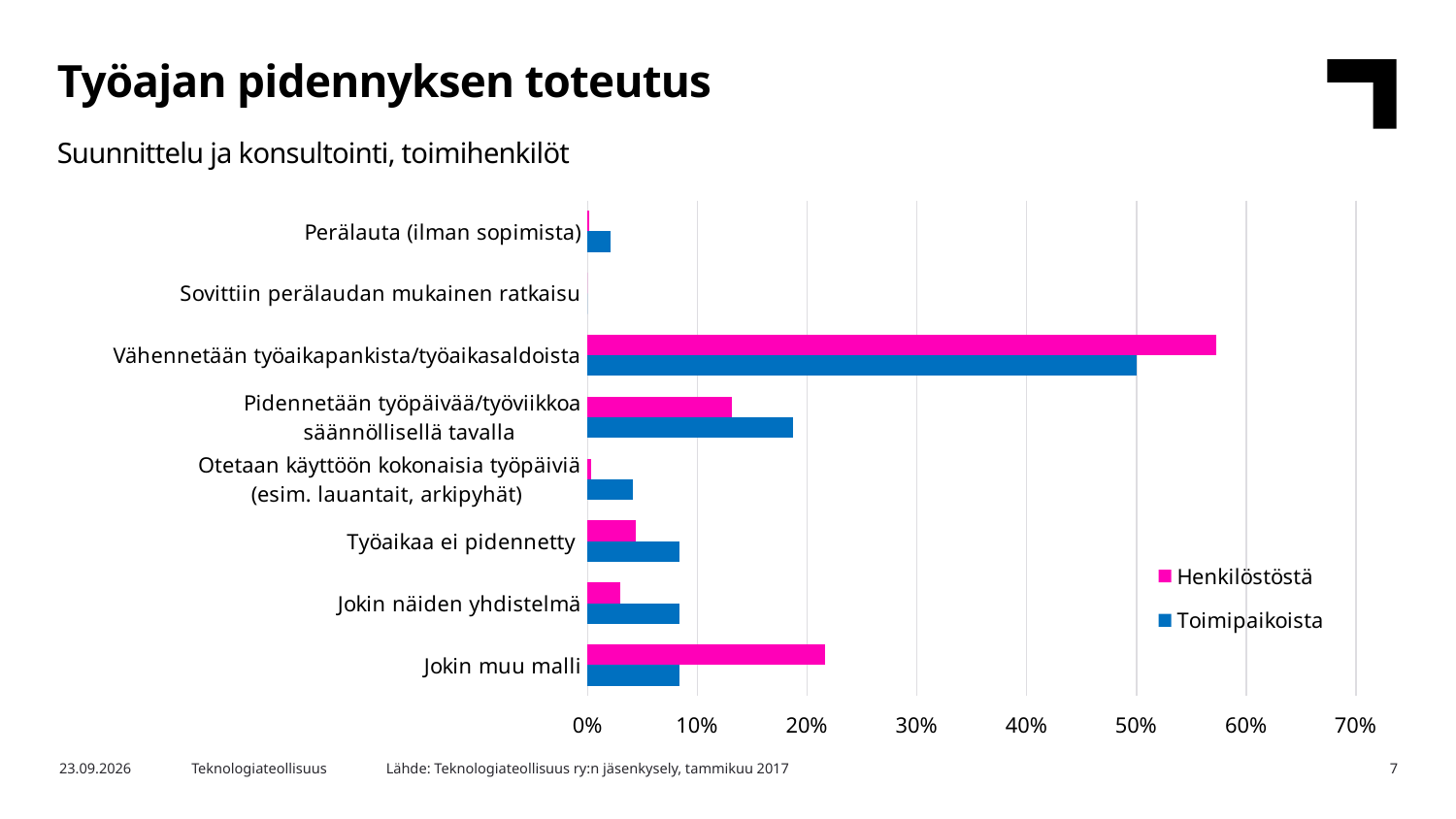
Is the Toimipaikoista value for Työaikaa ei pidennetty greater or less than 10%? less Is the Henkilöstöstä value for Vähennetään työaikapankista/työaikasaldoista greater or less than 50%? greater For Jokin muu malli, which series has the larger value, Henkilöstöstä or Toimipaikoista? Henkilöstöstä Is the Toimipaikoista value for Pidennetään työpäivää/työviikkoa säännöllisellä tavalla greater or less than 20%? less What kind of chart is shown on the slide? bar chart How many categories are shown on the vertical axis of the chart? 8 Which category has the highest value for the Henkilöstöstä series? Vähennetään työaikapankista/työaikasaldoista How many series does the legend list? 2 Which colour represents the Toimipaikoista series in the chart? blue For Pidennetään työpäivää/työviikkoa säännöllisellä tavalla, which series has the larger value, Henkilöstöstä or Toimipaikoista? Toimipaikoista Which category has the highest value for the Toimipaikoista series? Vähennetään työaikapankista/työaikasaldoista